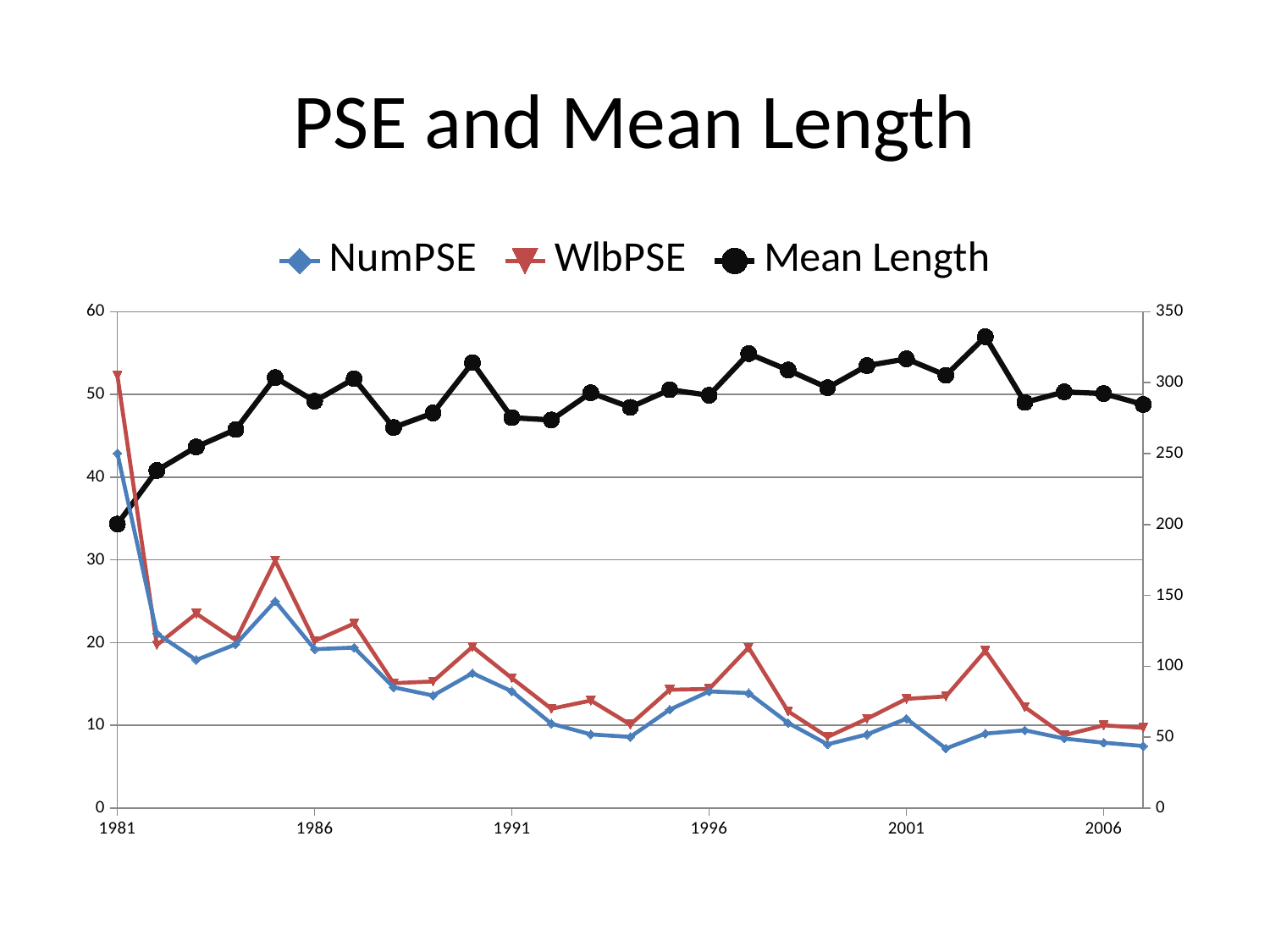
Is the value for Mean Length in 2001 greater or less than 300? greater Is the value for Mean Length in 1981 greater or less than 250? less Is the value for NumPSE in 1981 greater or less than 40? greater Which series is plotted with black circle markers? Mean Length What type of chart is shown on the slide? line chart What is the title of the chart? PSE and Mean Length How many series does the legend list? 3 In which year is NumPSE at its highest? 1981 In which year is Mean Length at its lowest? 1981 Does NumPSE generally rise or fall from 1981 to 2006? fall